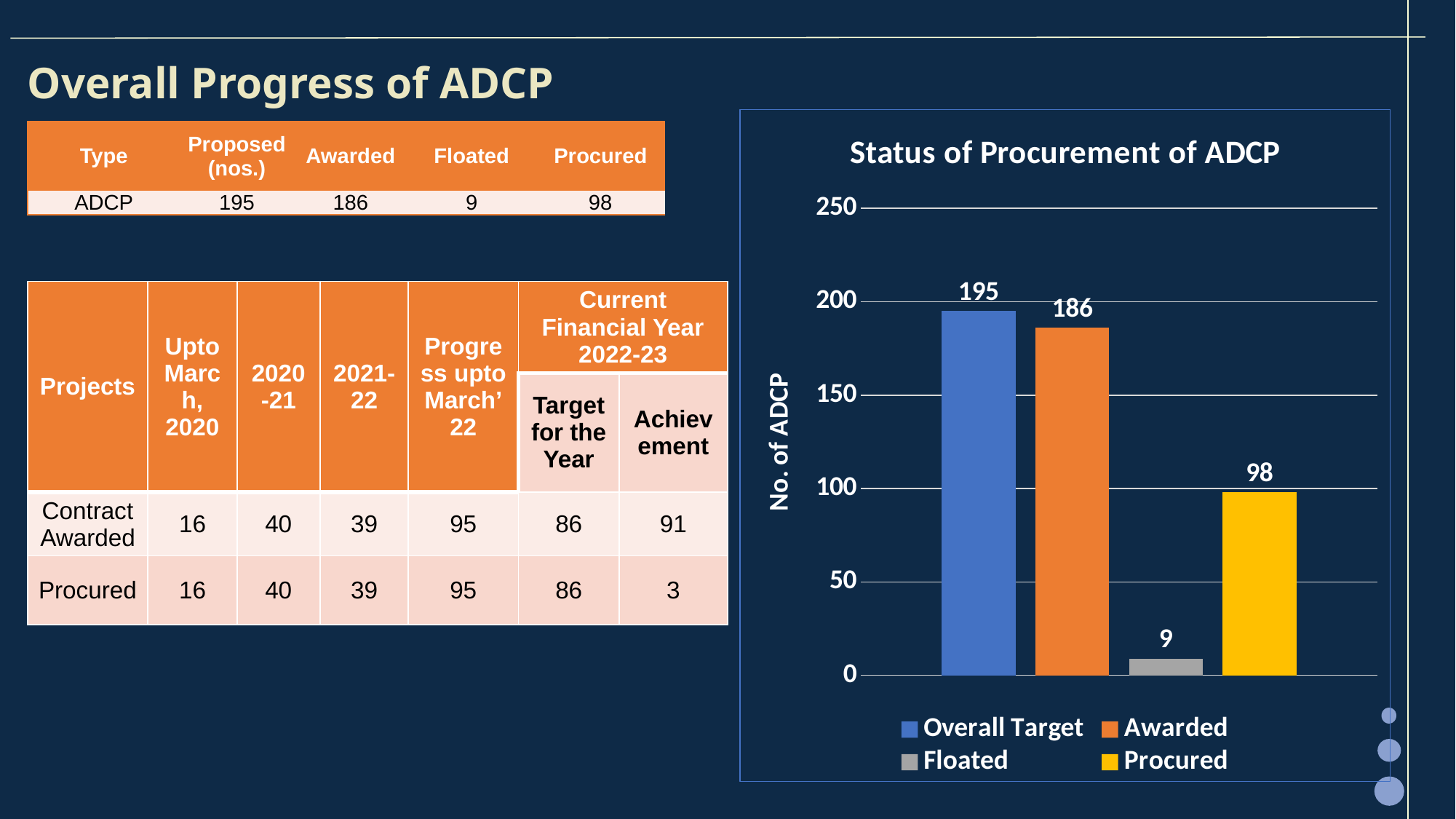
What is the difference between the Overall Target and Awarded values in the chart? 9 What kind of chart is shown on the slide? Bar chart What is the value of the Overall Target bar in the Status of Procurement of ADCP chart? 195 What is the value of the Floated bar in the chart? 9 What is the y-axis title of the chart? No. of ADCP Which series has the lowest value in the chart? Floated What is the value of the Procured bar in the chart? 98 What is the difference between the Awarded and Procured values in the chart? 88 What is the value of the Awarded bar in the chart? 186 Which series has the highest value in the chart? Overall Target How many series does the chart legend list? 4 Which is larger in the chart, Procured or Floated? Procured